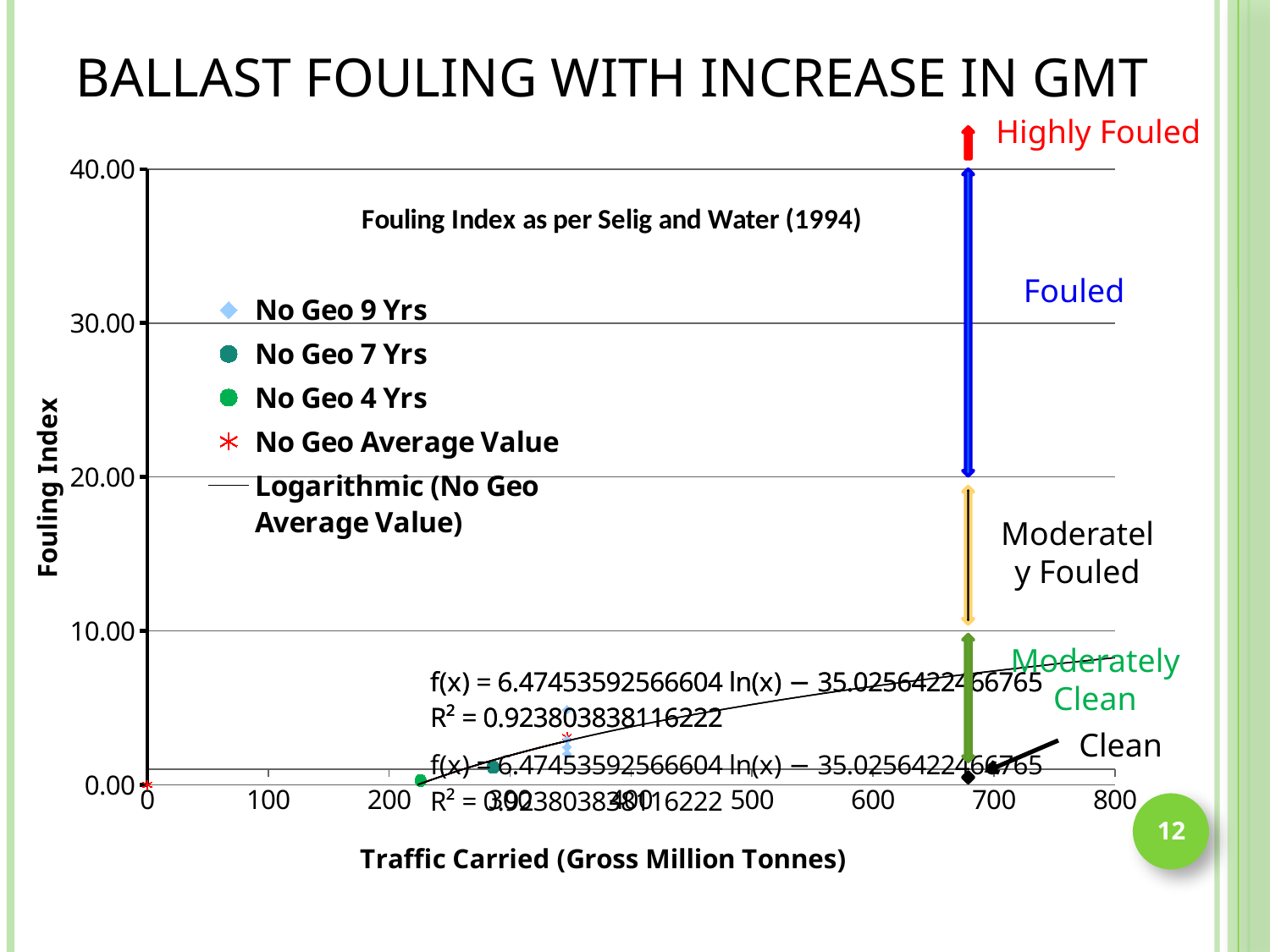
What is the label of the x axis? Traffic Carried (Gross Million Tonnes) What is the highest tick value shown on the Fouling Index axis? 40.00 Does the logarithmic trendline rise or fall as Traffic Carried increases? rises Is the Fouling Index value for No Geo 9 Yrs greater or less than 10.00? less What R² value is printed for the logarithmic trendline? 0.923803838116222 What equation is printed for the logarithmic trendline? f(x) = 6.47453592566604 ln(x) − 35.0256422466765 Is the Fouling Index value for No Geo 4 Yrs greater or less than 10.00? less How many series does the chart legend list? 5 Which series is plotted at the lowest Traffic Carried value? No Geo Average Value What kind of chart is shown on the slide? Scatter chart Which series has the higher Fouling Index, No Geo 9 Yrs or No Geo 4 Yrs? No Geo 9 Yrs What is the title of the chart? Fouling Index as per Selig and Water (1994)